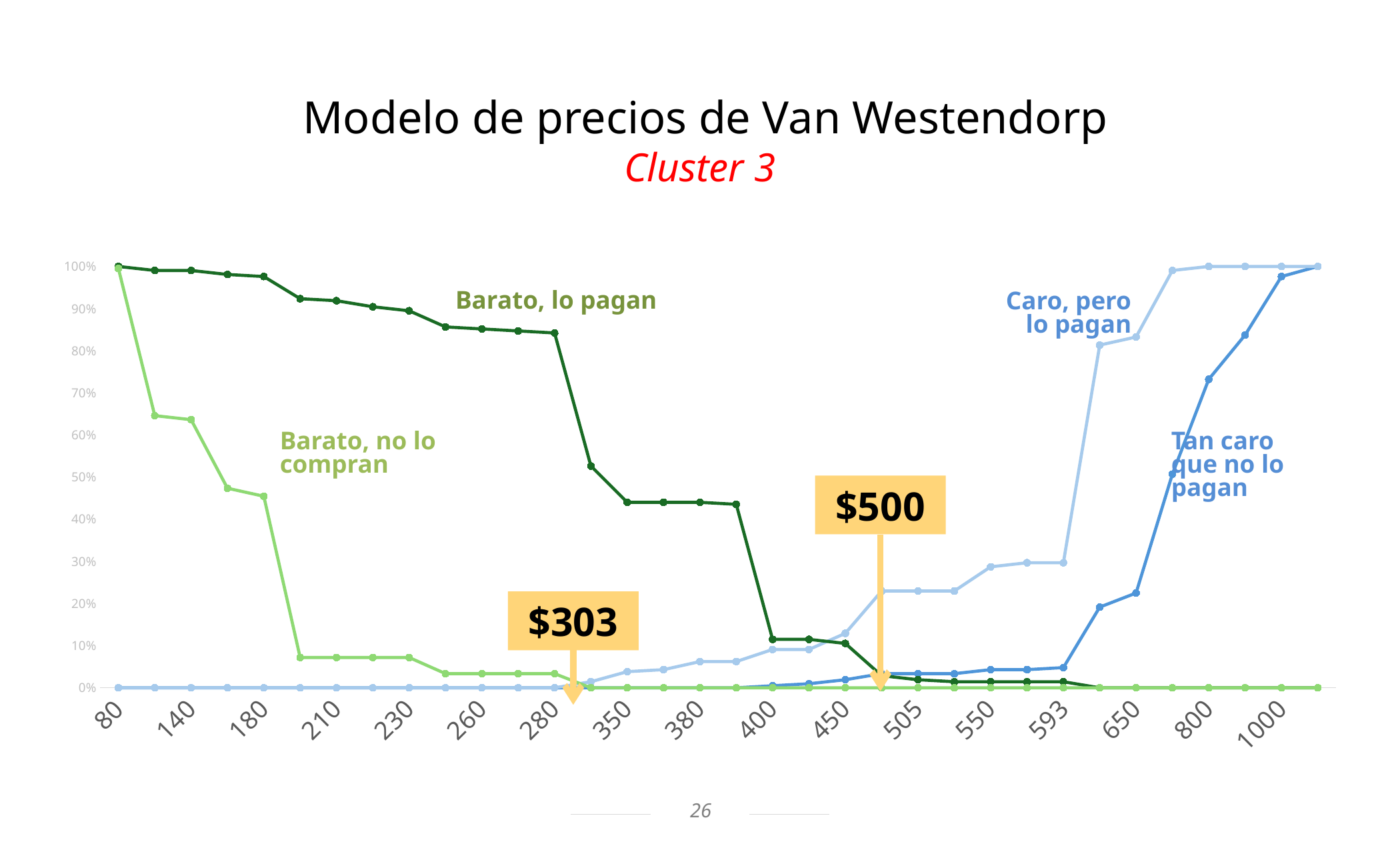
How many price labels are shown on the x axis? 17 Is the value of 'Barato, no lo compran' at 180 greater or less than 30%? greater Does the 'Barato, lo pagan' line rise or fall as the price increases along the x axis? fall Is the value of 'Barato, lo pagan' at 400 greater or less than 30%? less Is the value of 'Tan caro que no lo pagan' at 800 greater or less than 50%? greater What two price points are highlighted with yellow callout boxes on the chart? $303 and $500 What kind of chart is shown on the slide? line chart Does the 'Tan caro que no lo pagan' line rise or fall as the price increases along the x axis? rise How many data series are plotted on the chart? 4 At 650, which series has the higher value: 'Caro, pero lo pagan' or 'Tan caro que no lo pagan'? Caro, pero lo pagan